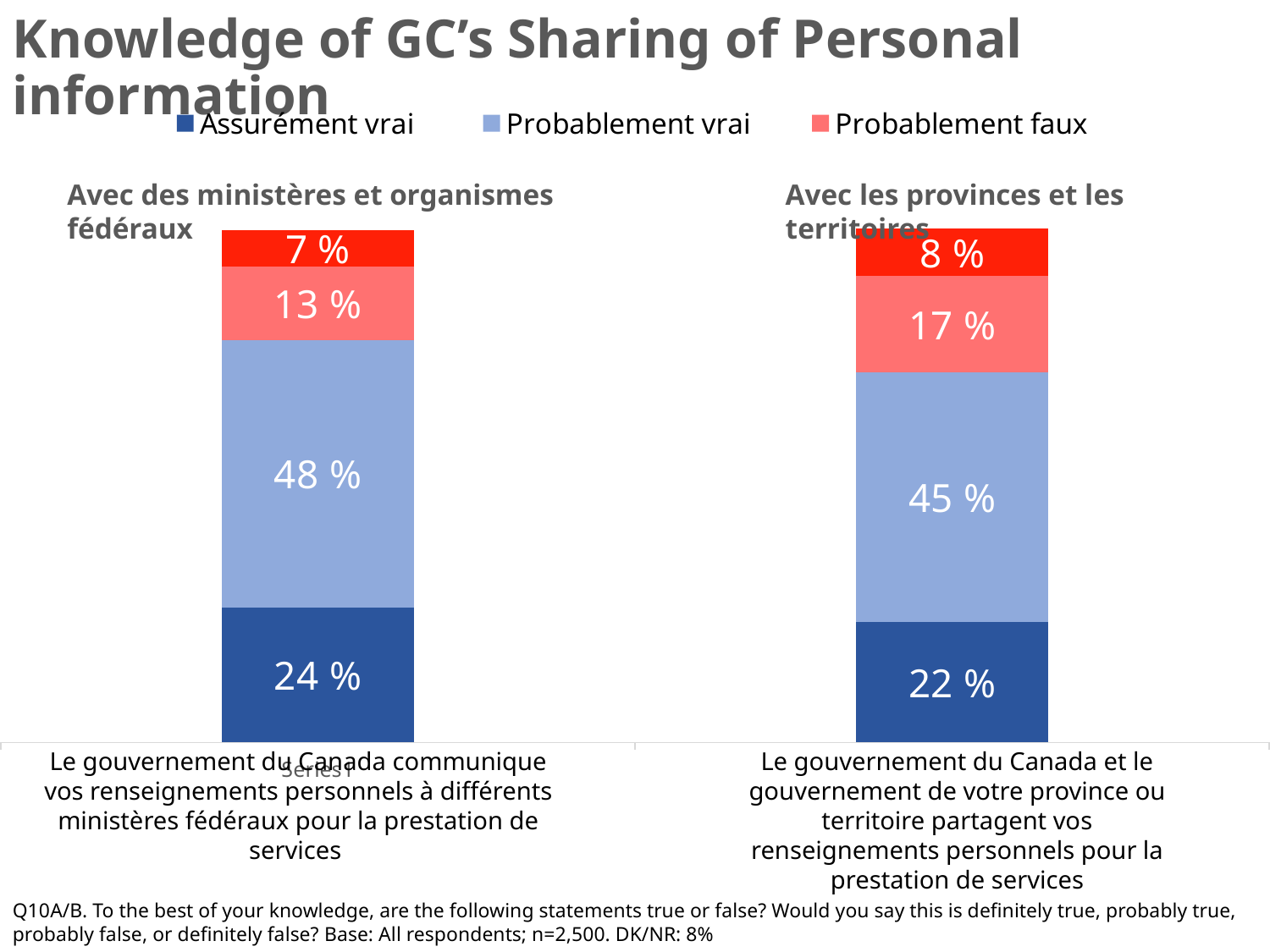
How many series does the legend at the top of the slide list? 3 Which chart shows the larger value for 'Probablement faux', 'Avec des ministères et organismes fédéraux' or 'Avec les provinces et les territoires'? Avec les provinces et les territoires In the chart 'Avec des ministères et organismes fédéraux', what percentage is shown for 'Probablement vrai'? 48 % In the chart 'Avec les provinces et les territoires', what percentage is shown for 'Assurément vrai'? 22 % In the chart 'Avec des ministères et organismes fédéraux', what is the total of all the labelled segments in the bar (24 %, 48 %, 13 %, 7 %)? 92 % What is the difference between the 'Probablement vrai' value in the left chart (48 %) and in the right chart (45 %)? 3 % In the chart 'Avec les provinces et les territoires', what percentage is shown for 'Probablement faux'? 17 % In the chart 'Avec des ministères et organismes fédéraux', what percentage is shown for 'Assurément vrai'? 24 % In the chart 'Avec des ministères et organismes fédéraux', how much larger is 'Probablement vrai' than 'Assurément vrai'? 24 % In the chart 'Avec les provinces et les territoires', which legend category has the largest segment? Probablement vrai What kind of chart is used on this slide? Stacked bar chart In the chart 'Avec des ministères et organismes fédéraux', what value is printed on the topmost bright red segment of the bar? 7 %